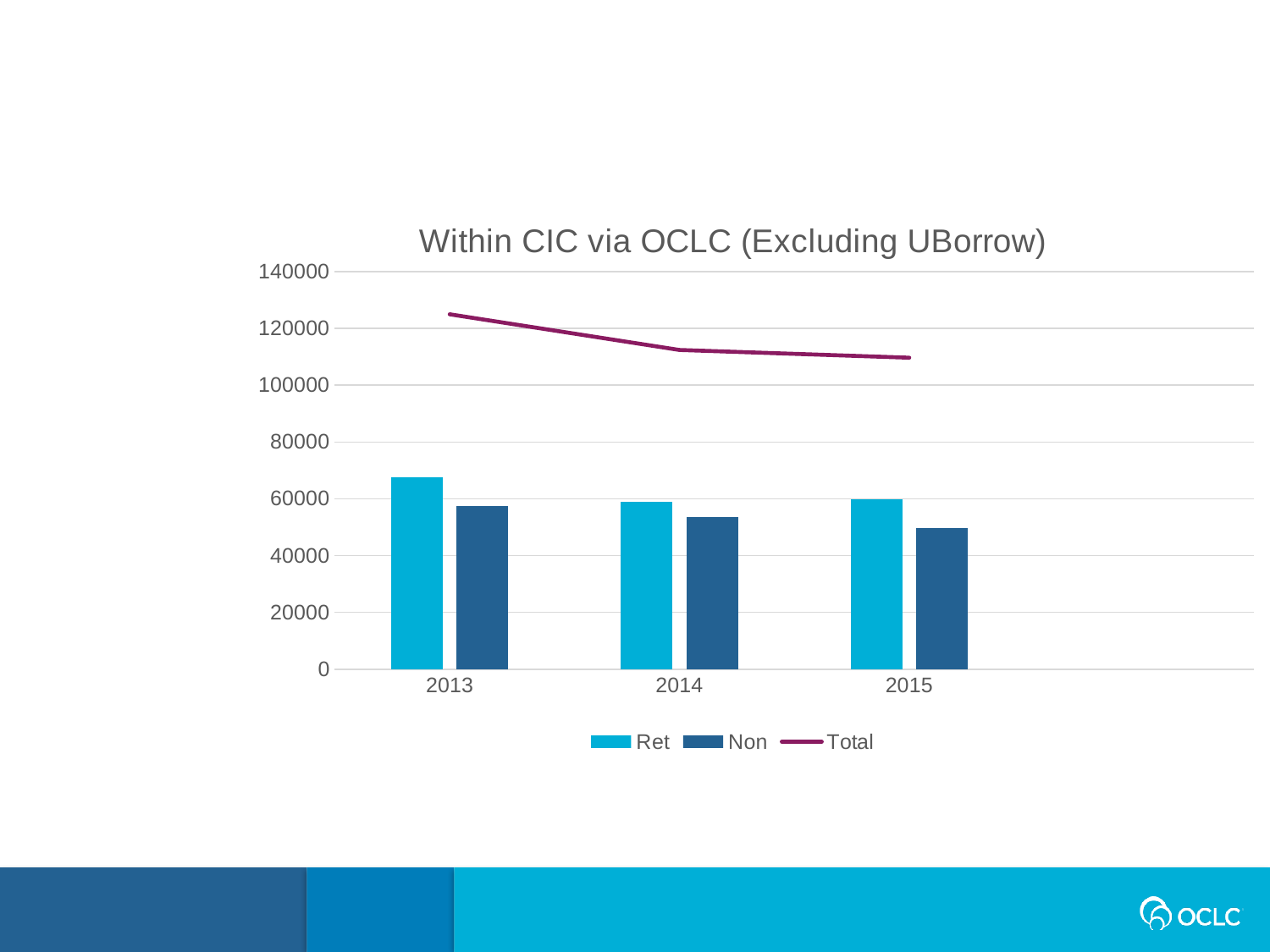
In which year is the Ret bar highest? 2013 Which series is drawn as a line rather than bars? Total In 2013, which is larger, Ret or Non? Ret How many years are shown on the x axis? 3 In which year is the Non bar lowest? 2015 How many series does the legend list? 3 Does the Total line rise or fall from 2013 to 2015? Fall What kind of chart is this? Combined bar and line chart Is the Non value for 2015 greater or less than 60000? less What is the title of the chart? Within CIC via OCLC (Excluding UBorrow) Is the Ret value for 2013 greater or less than 60000? greater Is the Total value for 2013 greater or less than 120000? greater